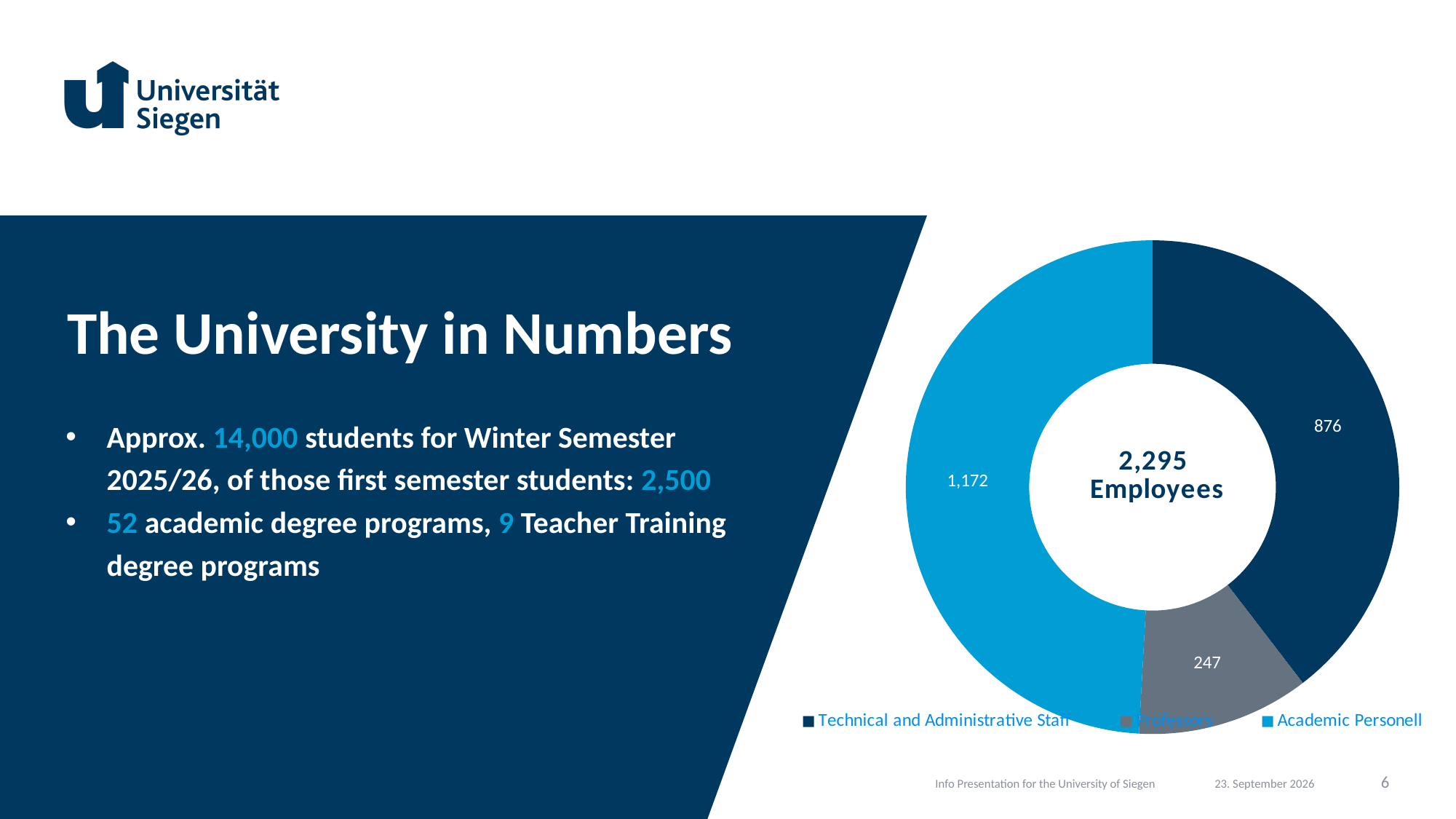
How many Professors does the chart show? 247 How many employee categories does the chart show? 3 Which colour represents Professors in the chart? Grey How many employees are Academic Personell according to the chart? 1,172 Which is larger: the number of Technical and Administrative Staff or the number of Professors? Technical and Administrative Staff How many employees are Technical and Administrative Staff according to the chart? 876 What kind of chart is shown on the slide? Pie chart (donut) Which employee group has the smallest slice in the chart? Professors What is the difference between the number of Academic Personell and the number of Technical and Administrative Staff? 296 Which employee group has the largest slice in the chart? Academic Personell What total number of employees is shown in the centre of the chart? 2,295 What is the difference between the number of Technical and Administrative Staff and the number of Professors? 629